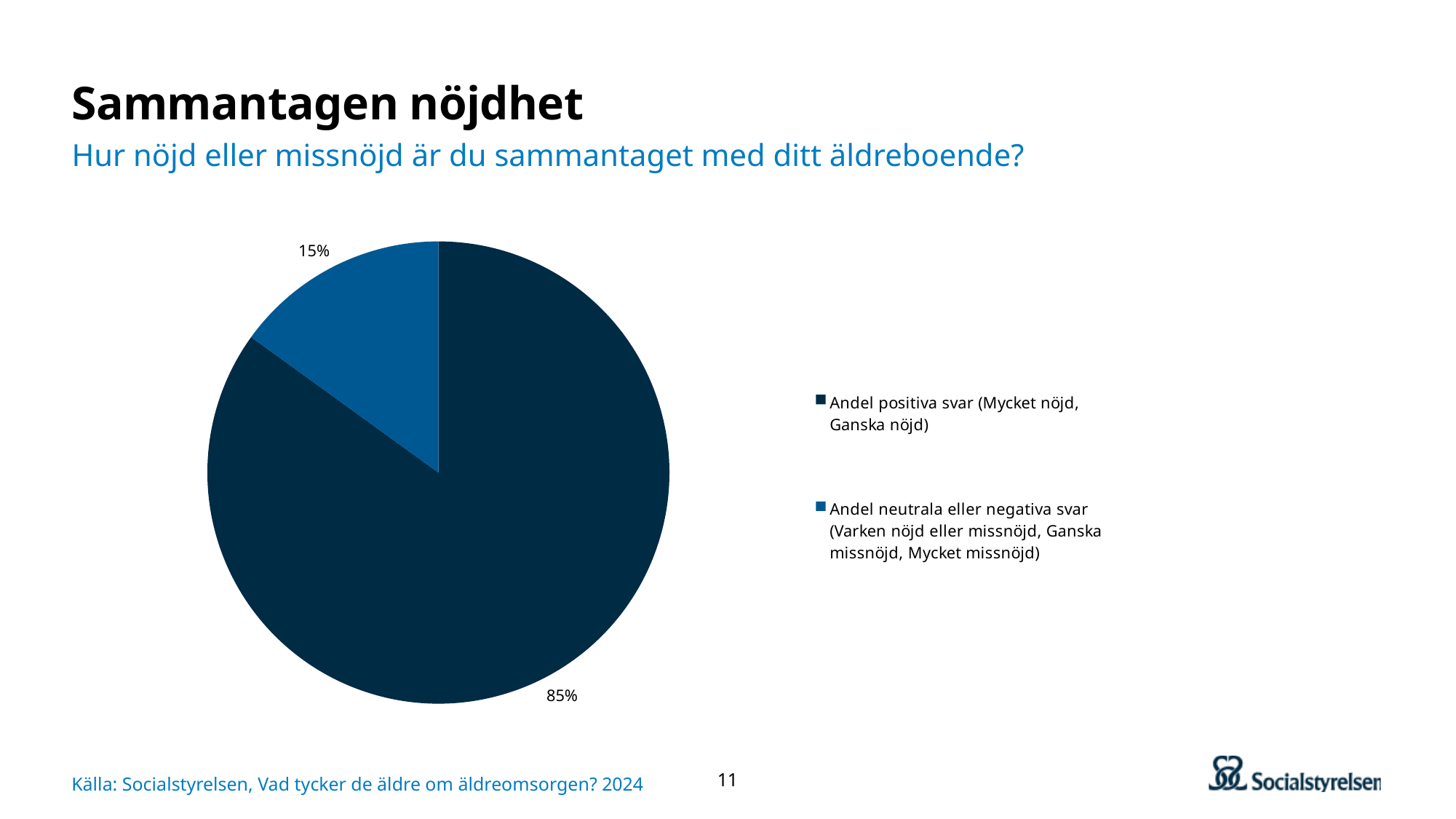
What is the total of the two slices shown in the pie chart? 100% Which slice of the pie is the smallest? Andel neutrala eller negativa svar (Varken nöjd eller missnöjd, Ganska missnöjd, Mycket missnöjd) Which is larger: the share of positive answers or the share of neutral or negative answers? Andel positiva svar (Mycket nöjd, Ganska nöjd) What question is the chart based on, as shown in the subtitle? Hur nöjd eller missnöjd är du sammantaget med ditt äldreboende? What share of the pie is 'Andel neutrala eller negativa svar (Varken nöjd eller missnöjd, Ganska missnöjd, Mycket missnöjd)'? 15% Which slice of the pie is the largest? Andel positiva svar (Mycket nöjd, Ganska nöjd) What kind of chart is shown on the slide? pie chart What is the source cited at the bottom of the slide? Socialstyrelsen, Vad tycker de äldre om äldreomsorgen? 2024 How many entries does the legend list? 2 What is the difference in percentage points between the positive-answer slice and the neutral-or-negative slice? 70 percentage points What share of the pie is 'Andel positiva svar (Mycket nöjd, Ganska nöjd)'? 85% How many slices does the pie chart have? 2